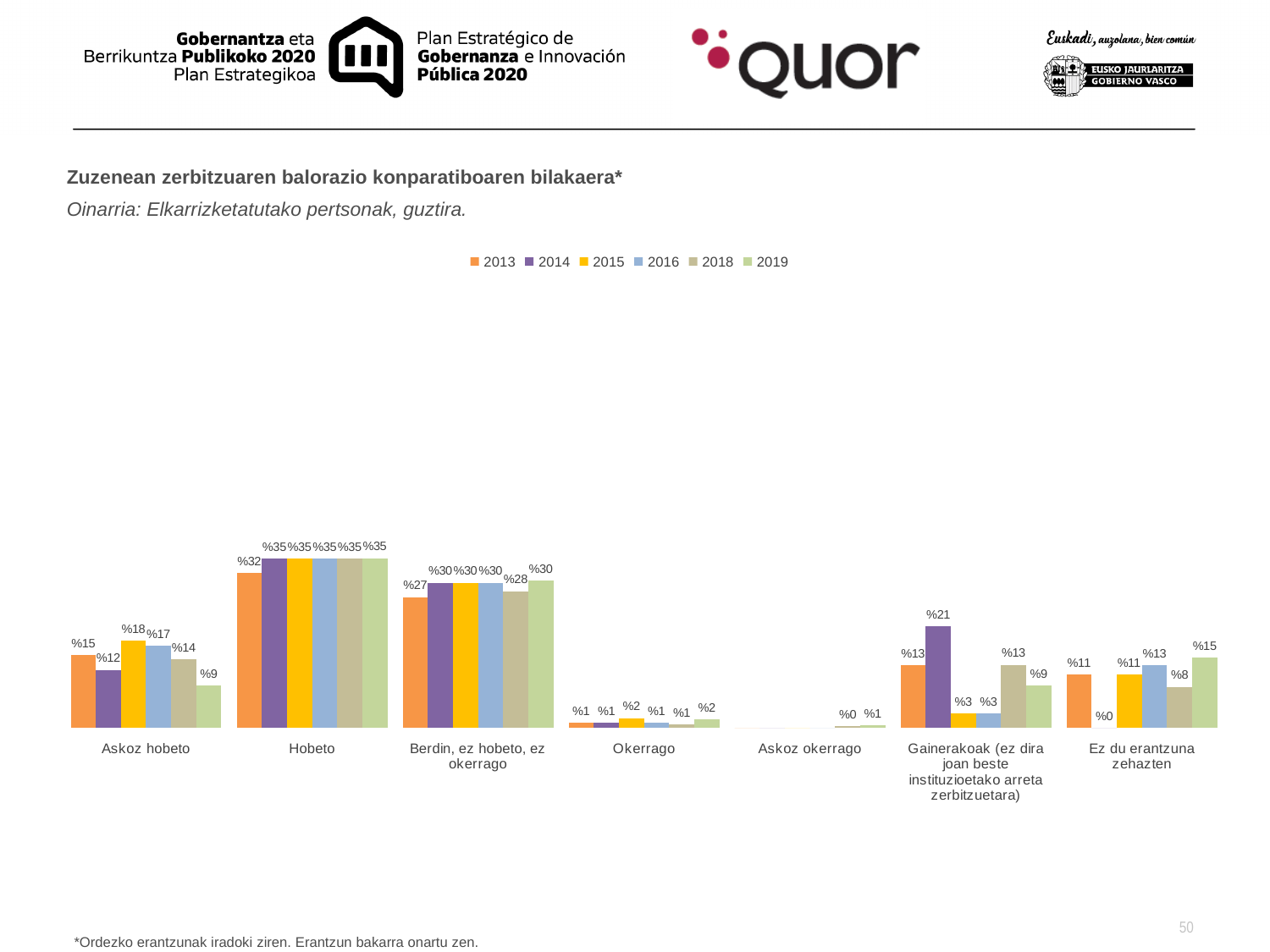
Which year has the highest value in the "Askoz hobeto" category? 2015 Which year has the lowest value in the "Ez du erantzuna zehazten" category? 2014 Which is larger in the "Ez du erantzuna zehazten" category: the 2016 value or the 2019 value? 2019 What kind of chart is shown on the slide? Bar chart What is the value for 2018 in the "Berdin, ez hobeto, ez okerrago" category? %28 How many series does the legend list? 6 What is the value for 2013 in the "Hobeto" category? %32 What is the difference between the 2014 and 2015 values in the "Gainerakoak (ez dira joan beste instituzioetako arreta zerbitzuetara)" category? %18 What is the value for 2019 in the "Askoz hobeto" category? %9 How many categories are shown on the x axis? 7 What is the value for 2014 in the "Gainerakoak (ez dira joan beste instituzioetako arreta zerbitzuetara)" category? %21 Which years are listed in the chart legend? 2013, 2014, 2015, 2016, 2018, 2019